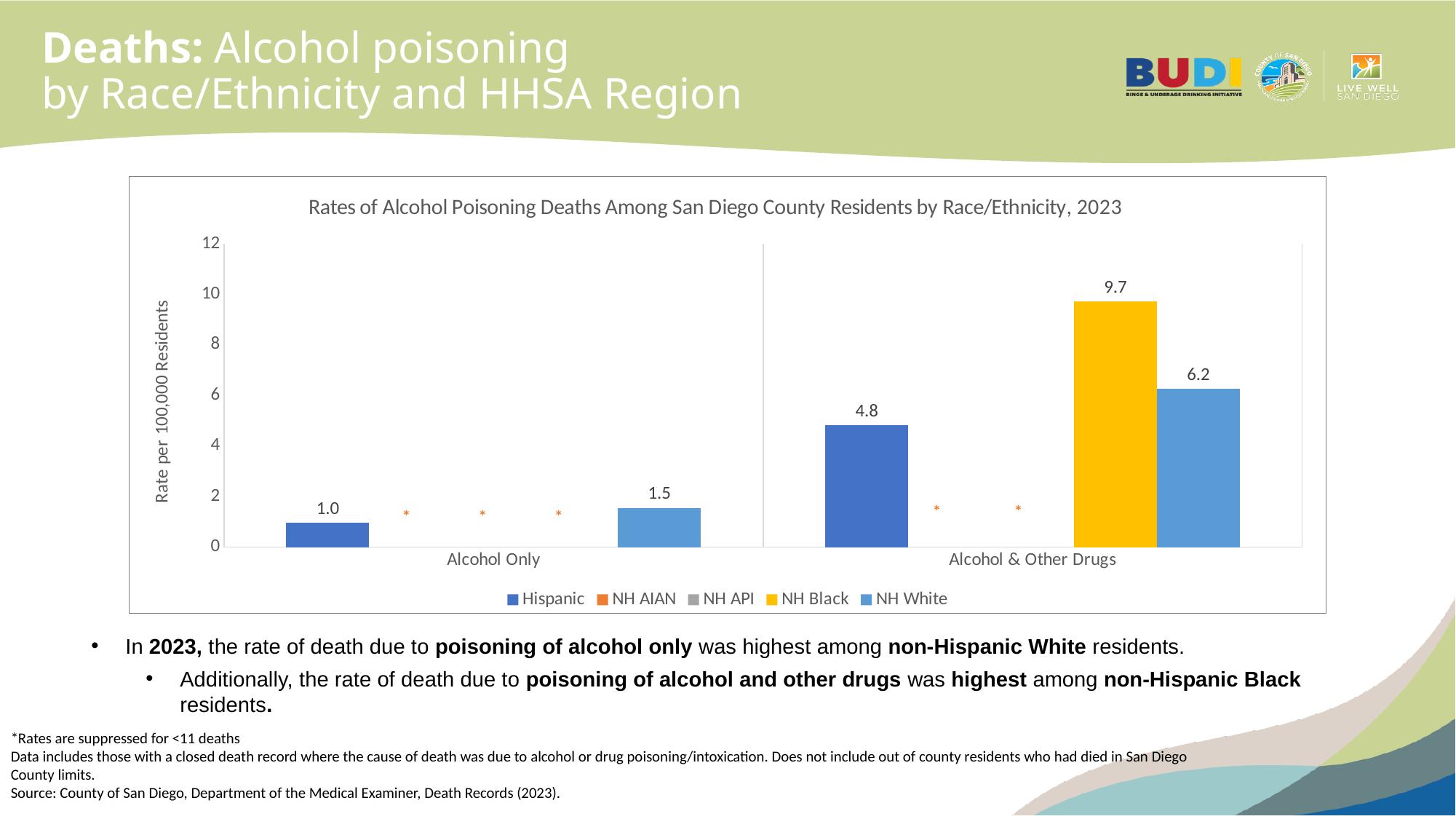
What kind of chart is shown on the slide? Bar chart What is the rate for NH Black residents in the Alcohol & Other Drugs category? 9.7 What colour represents NH Black in the chart? Yellow How many series does the legend list? 5 What is the rate for Hispanic residents in the Alcohol & Other Drugs category? 4.8 What is the rate for NH White residents in the Alcohol & Other Drugs category? 6.2 What is the rate for Hispanic residents in the Alcohol Only category? 1.0 What is the rate for NH White residents in the Alcohol Only category? 1.5 What is the difference between the NH Black and NH White rates in the Alcohol & Other Drugs category? 3.5 Which race/ethnicity group has the highest rate in the Alcohol & Other Drugs category? NH Black Is the NH Black rate in the Alcohol & Other Drugs category greater or less than 8? greater In the Alcohol Only category, which is larger: the Hispanic rate or the NH White rate? NH White